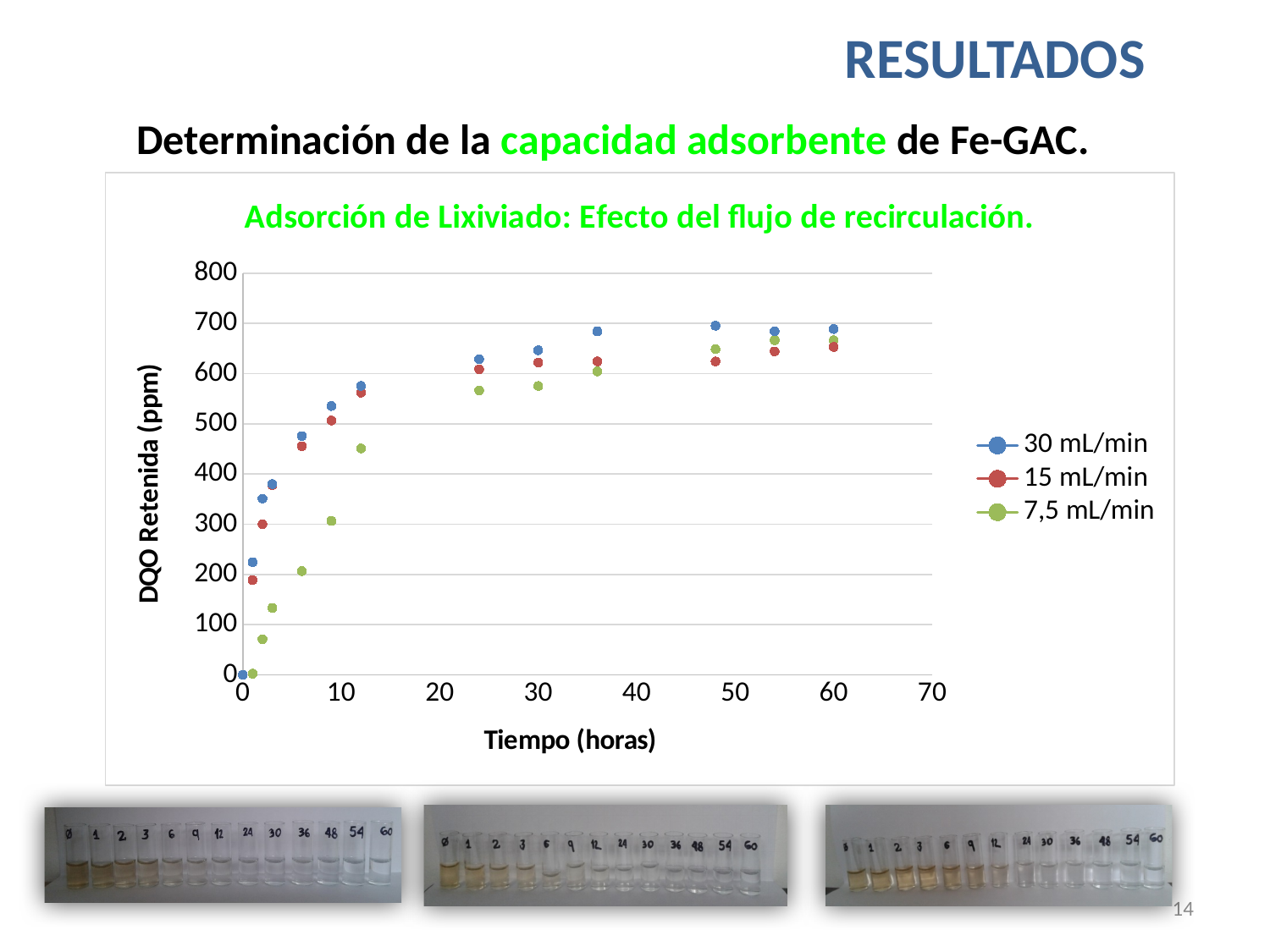
Is the value for 7,5 mL/min at 24 hours greater or less than 600? less What is the title of the chart? Adsorción de Lixiviado: Efecto del flujo de recirculación. Is the value for 30 mL/min at 12 hours greater or less than 500? greater How many series does the legend of the chart list? 3 Is the value for 7,5 mL/min at 3 hours greater or less than 100? greater What kind of chart is shown on the slide? Scatter chart What is the label of the vertical axis of the chart? DQO Retenida (ppm) Do the DQO Retenida values for the 30 mL/min series rise or fall as time increases? Rise Which series has the highest DQO Retenida value at 12 hours? 30 mL/min At 3 hours, which series has the larger DQO Retenida value: 30 mL/min or 7,5 mL/min? 30 mL/min At 9 hours, which series has the larger value: 15 mL/min or 7,5 mL/min? 15 mL/min